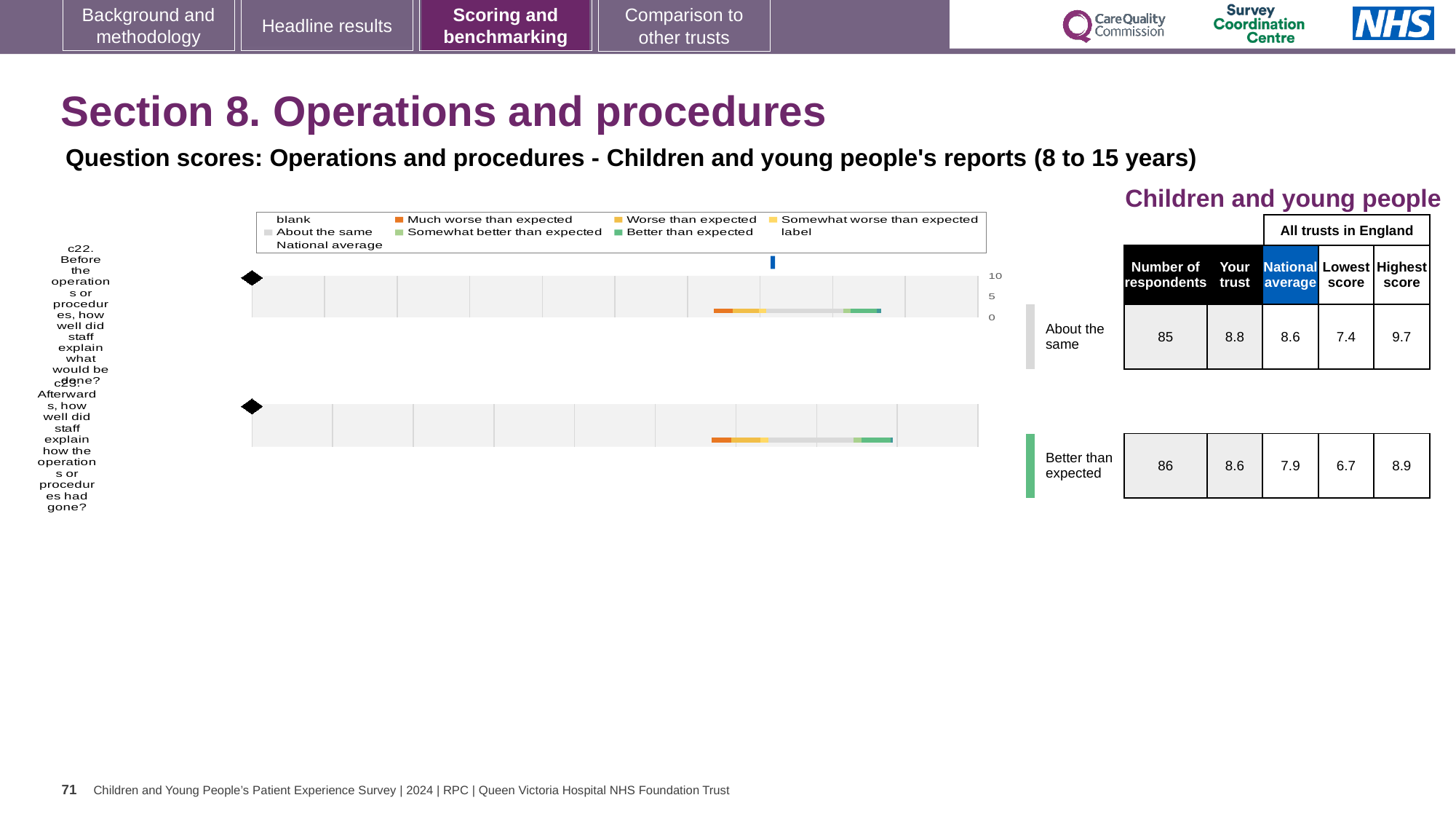
How many entries does the chart legend list? 9 What kind of chart is used to show the question scores for c22 and c23? bar chart What benchmark category is shown next to the c23 chart row? Better than expected What is the 'Your trust' score for c23 (Afterwards, how well did staff explain how the operations or procedures had gone?)? 8.6 Which legend entry is shown in orange? Much worse than expected Which legend entry is shown in dark green? Better than expected What is the national average for c23? 7.9 What is the difference between the 'Your trust' score and the national average for c23? 0.7 What is the highest value shown on the chart's axis? 10 What is the 'Your trust' score for c22 (Before the operations or procedures, how well did staff explain what would be done?)? 8.8 What benchmark category is shown next to the c22 chart row? About the same How many questions (categories) are plotted in the charts on this slide? 2